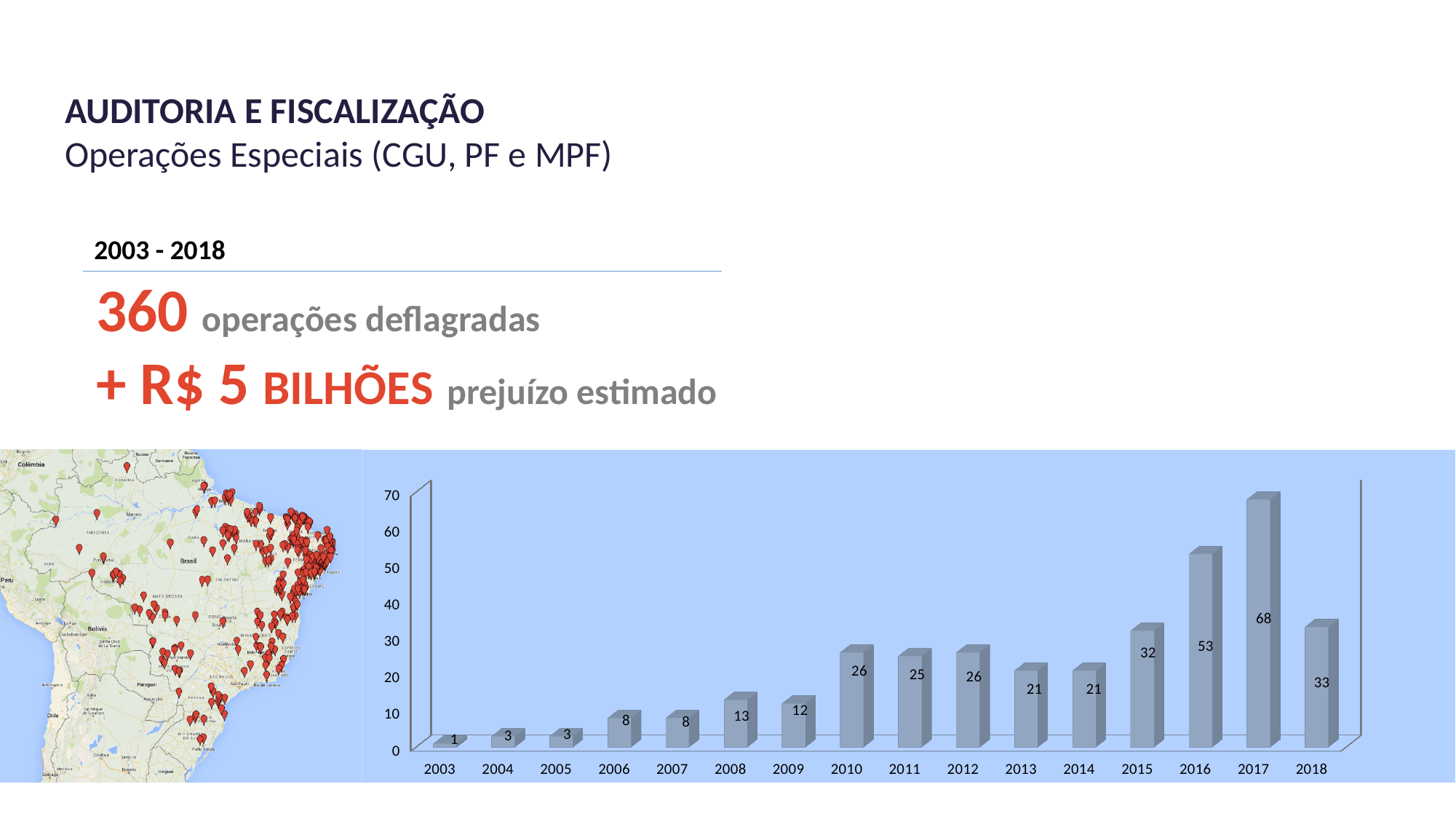
What is the value for 2017? 68 What is the difference between the values for 2017 and 2016? 15 Do the values generally rise or fall from 2003 to 2017? rise What is the value for 2010? 26 Which year has the highest value? 2017 What kind of chart is shown on the slide? bar chart Which year has the lowest value? 2003 How many years are shown on the x axis? 16 Which is larger, the value for 2015 or the value for 2018? 2018 Is the value for 2016 greater or less than 50? greater What is the value for 2003? 1 What is the difference between the values for 2018 and 2017? 35